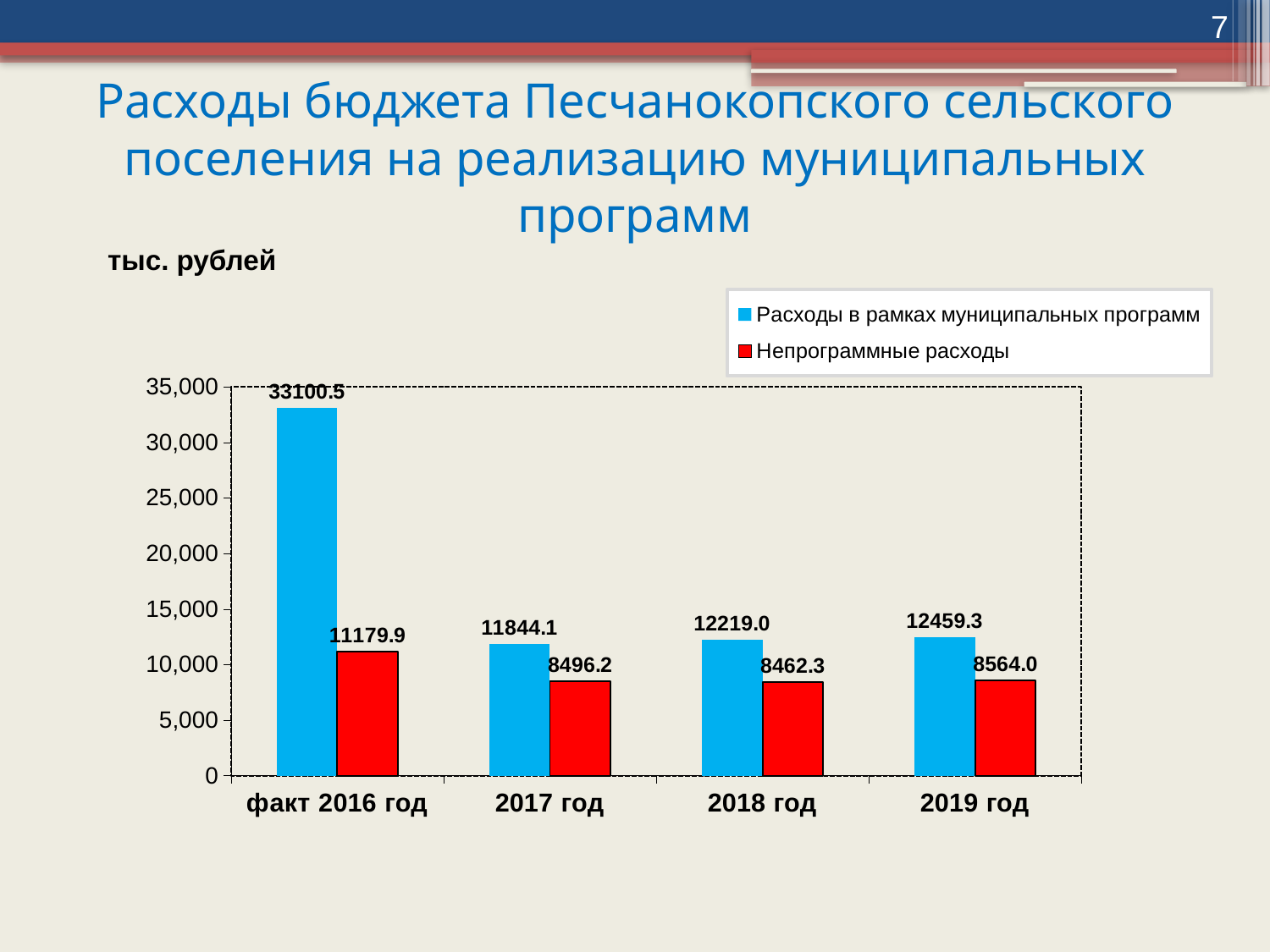
What is the difference between 'Расходы в рамках муниципальных программ' and 'Непрограммные расходы' for '2017 год'? 3347.9 Does 'Расходы в рамках муниципальных программ' rise or fall from '2017 год' to '2019 год'? rise Which is larger: 'Непрограммные расходы' for 'факт 2016 год' or for '2019 год'? факт 2016 год Which category has the lowest value for 'Непрограммные расходы'? 2018 год Which category has the highest value for 'Расходы в рамках муниципальных программ'? факт 2016 год What is the value of 'Расходы в рамках муниципальных программ' for 'факт 2016 год'? 33100.5 How many series does the legend list? 2 Is the value of 'Расходы в рамках муниципальных программ' for '2018 год' greater or less than 10,000? greater What is the value of 'Расходы в рамках муниципальных программ' for '2019 год'? 12459.3 What is the value of 'Непрограммные расходы' for '2018 год'? 8462.3 How many categories are shown on the x axis? 4 What kind of chart is shown on the slide? bar chart